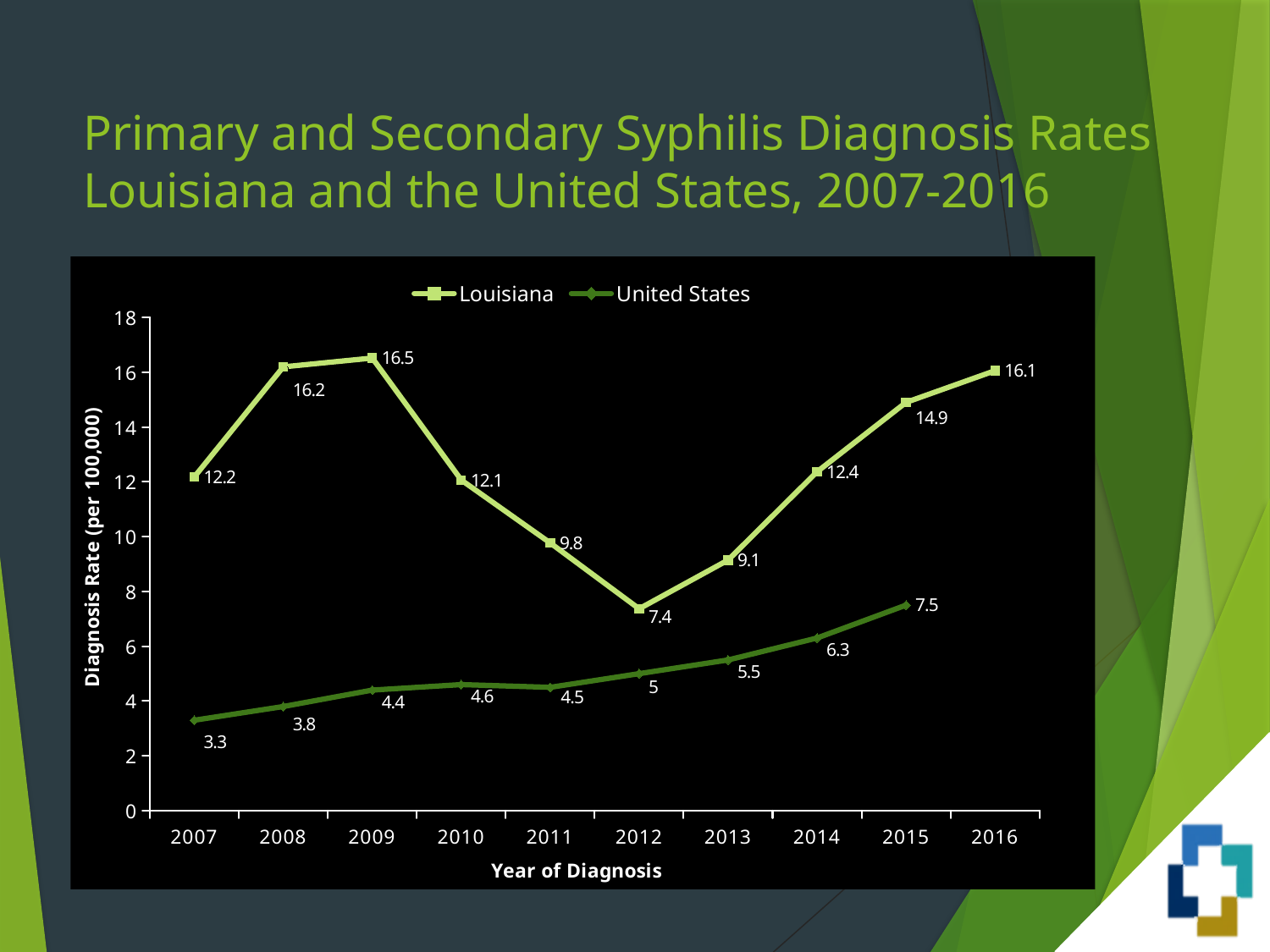
Does the United States diagnosis rate rise or fall from 2007 to 2015? Rise In which year is the Louisiana diagnosis rate lowest? 2012 Is the Louisiana diagnosis rate in 2014 greater or less than 10? greater What is the Louisiana diagnosis rate in 2016? 16.1 How many years are shown on the x axis? 10 In which year is the Louisiana diagnosis rate highest? 2009 What is the difference between the Louisiana and United States diagnosis rates in 2015? 7.4 What kind of chart is shown on the slide? Line chart Which series has the higher diagnosis rate in 2013, Louisiana or United States? Louisiana What is the Louisiana diagnosis rate in 2009? 16.5 How many series does the legend list? 2 What is the United States diagnosis rate in 2012? 5